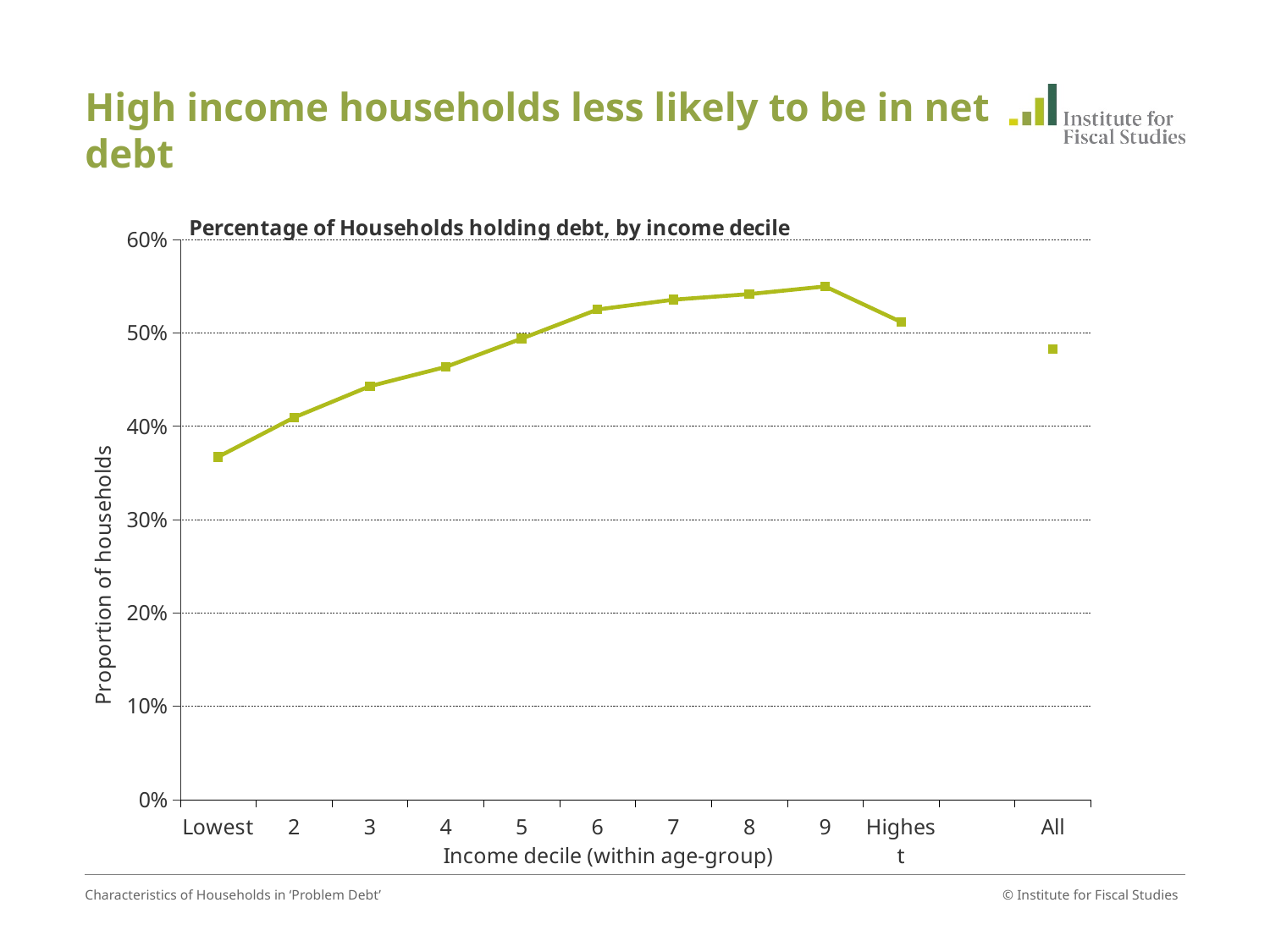
What kind of chart is shown on the slide? line chart How many categories are shown along the x axis of the chart? 11 Is the value for income decile 9 greater or less than 50%? greater Which income decile has the lowest proportion of households holding debt? Lowest Which income decile has the highest proportion of households holding debt? 9 Do the values rise or fall from the Lowest income decile to decile 9? rise Is the value for the Lowest income decile greater or less than 40%? less What is the label on the vertical axis of the chart? Proportion of households Which has a higher proportion of households holding debt, the Lowest decile or the Highest decile? Highest Is the value for All households greater or less than 50%? less What is the title of the chart? Percentage of Households holding debt, by income decile